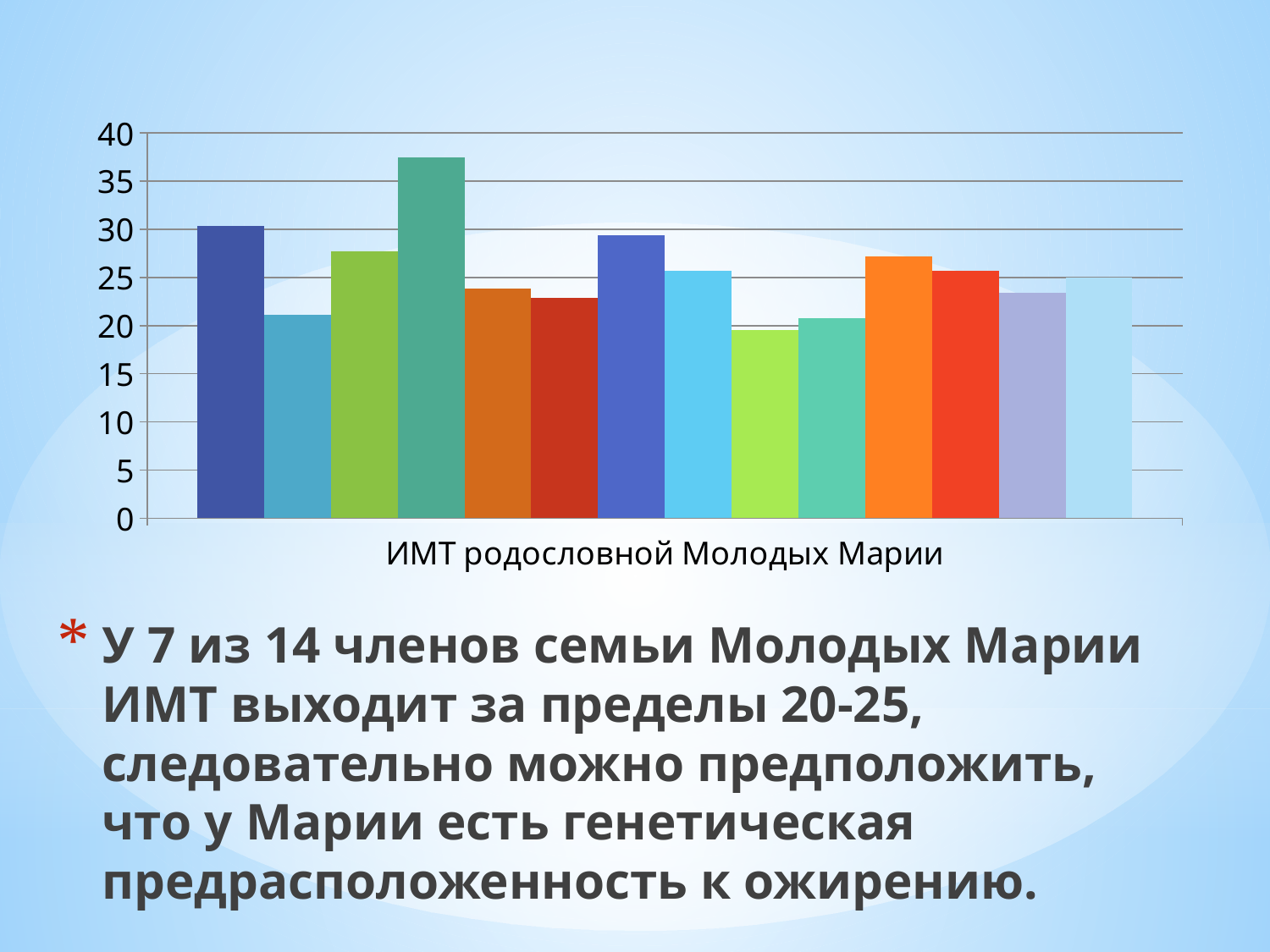
Is the value of the second bar from the left greater or less than 20? greater What kind of chart is shown on the slide? bar chart Is the value of the thirteenth bar from the left greater or less than 25? less What is the category label shown under the chart's x axis? ИМТ родословной Молодых Марии Which bar is the tallest in the chart? the fourth bar from the left How many bars are plotted in the chart? 14 Is the value of the third bar from the left greater or less than 25? greater What is the highest value shown on the chart's vertical axis? 40 Which is larger, the first bar from the left or the fourth bar from the left? the fourth bar from the left Which is larger, the tenth bar from the left or the eleventh bar from the left? the eleventh bar from the left